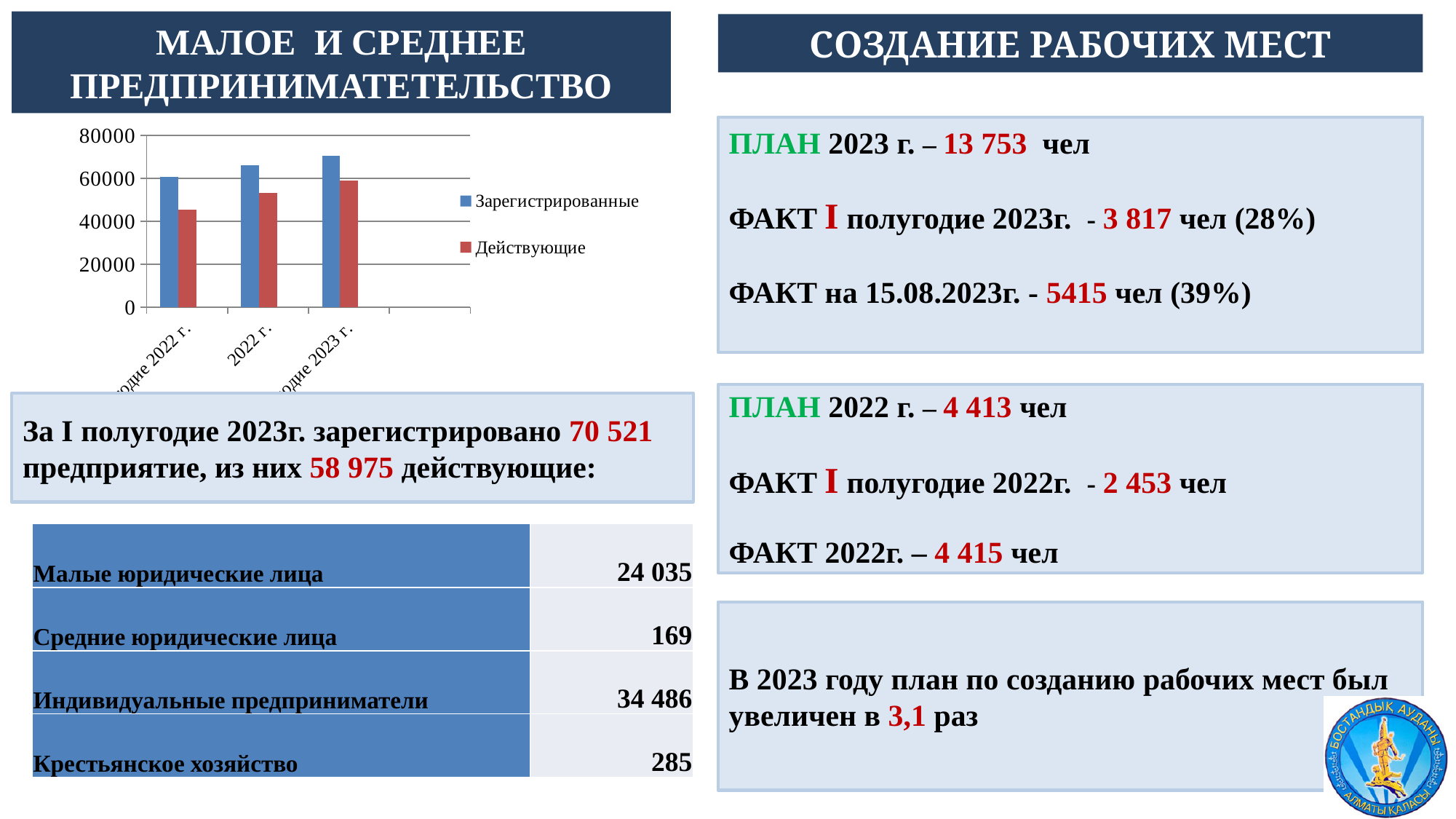
What are the two series named in the chart legend? Зарегистрированные and Действующие Which category has the highest Зарегистрированные value in the chart? the rightmost category (…2023 г.) Is the Действующие value for the rightmost category greater or less than 40000? greater How many series does the chart legend list? 2 Is the Действующие value for the leftmost category greater or less than 60000? less Which colour represents the Действующие series in the chart? red How many category groups are plotted on the x axis of the chart? 3 Which category has the lowest Действующие value in the chart? the leftmost category (…2022 г.) What kind of chart is shown on the slide? bar chart Is the Зарегистрированные value for 2022 г. greater or less than 60000? greater Do the Зарегистрированные values rise or fall from left to right across the categories? rise For the 2022 г. category, which is larger: Зарегистрированные or Действующие? Зарегистрированные